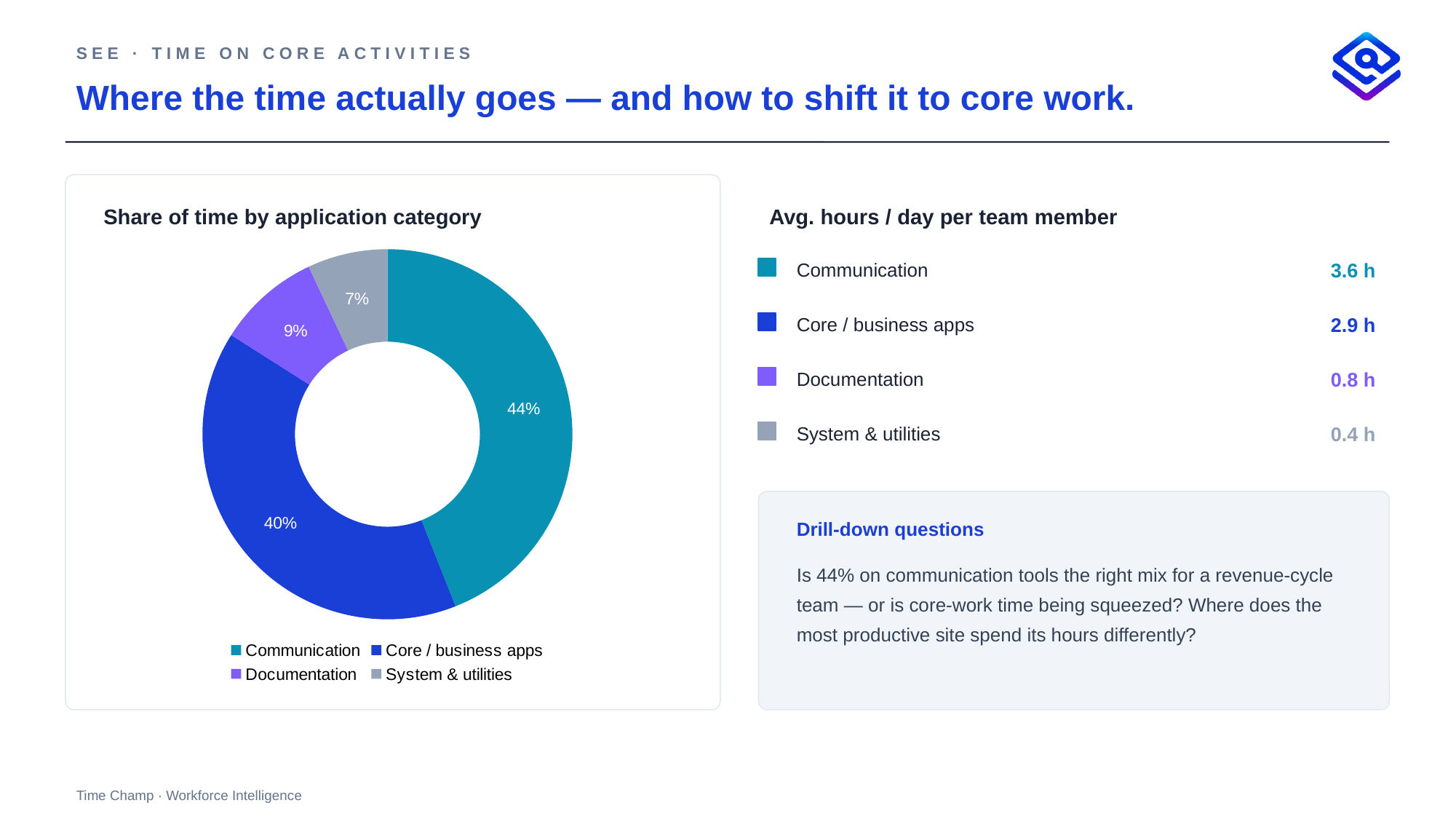
What share of time does Communication account for in the 'Share of time by application category' chart? 44% What share of time does Documentation account for in the donut chart? 9% What share of time does System & utilities account for in the donut chart? 7% What type of chart is used to show the share of time by application category? Donut (pie) chart In the donut chart, which has a larger share: Documentation or System & utilities? Documentation What is the title of the chart on the left of the slide? Share of time by application category In the donut chart, what is the combined share of Documentation and System & utilities? 16% Which application category has the smallest share of time in the donut chart? System & utilities Which application category has the largest share of time in the donut chart? Communication What share of time does Core / business apps account for in the donut chart? 40% In the donut chart, what is the difference in percentage points between the Communication and Core / business apps shares? 4 percentage points How many application categories are shown in the donut chart? 4